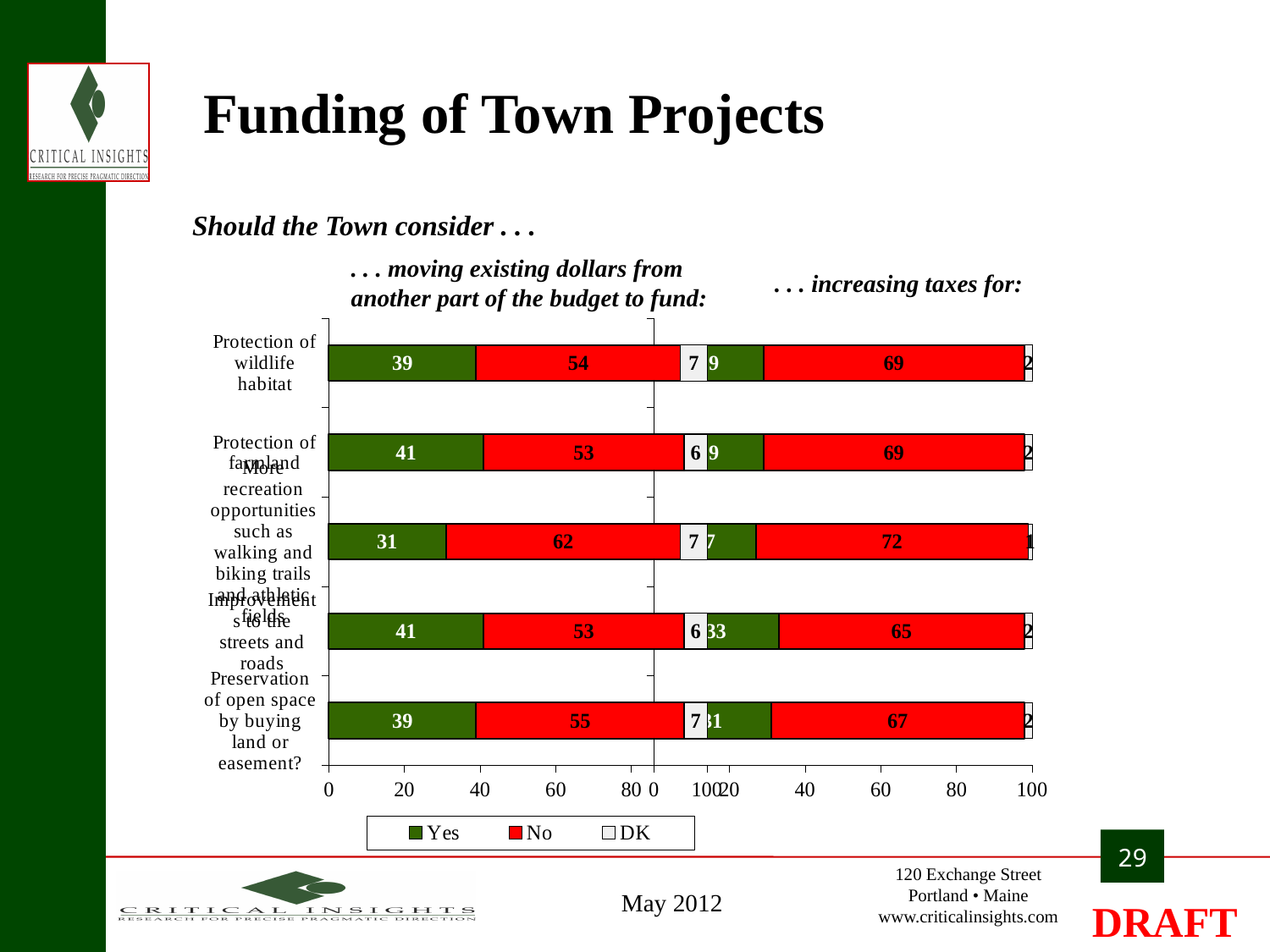
In the chart '. . . moving existing dollars from another part of the budget to fund:', which category has the lowest Yes value? More recreation opportunities such as walking and biking trails and athletic fields What type of chart is used on this slide? Stacked bar chart In the chart '. . . moving existing dollars from another part of the budget to fund:', what is the difference between the No and Yes values for Preservation of open space by buying land or easement? 16 In the chart '. . . moving existing dollars from another part of the budget to fund:', what is the No value for the recreation opportunities category? 62 In the chart '. . . moving existing dollars from another part of the budget to fund:', what percentage said Yes for Protection of wildlife habitat? 39 In the chart '. . . increasing taxes for:', which category has the highest No value? More recreation opportunities such as walking and biking trails and athletic fields In the chart '. . . increasing taxes for:', what is the No value for Improvements to the streets and roads? 65 How many categories are shown in the chart '. . . moving existing dollars from another part of the budget to fund:'? 5 How many series does the legend list? 3 In the chart '. . . moving existing dollars from another part of the budget to fund:', which category has the highest No value? More recreation opportunities such as walking and biking trails and athletic fields In the chart '. . . increasing taxes for:', is the No value for Preservation of open space larger or smaller than the No value for Improvements to the streets and roads? larger In the chart '. . . increasing taxes for:', what is the No value for Protection of farmland? 69